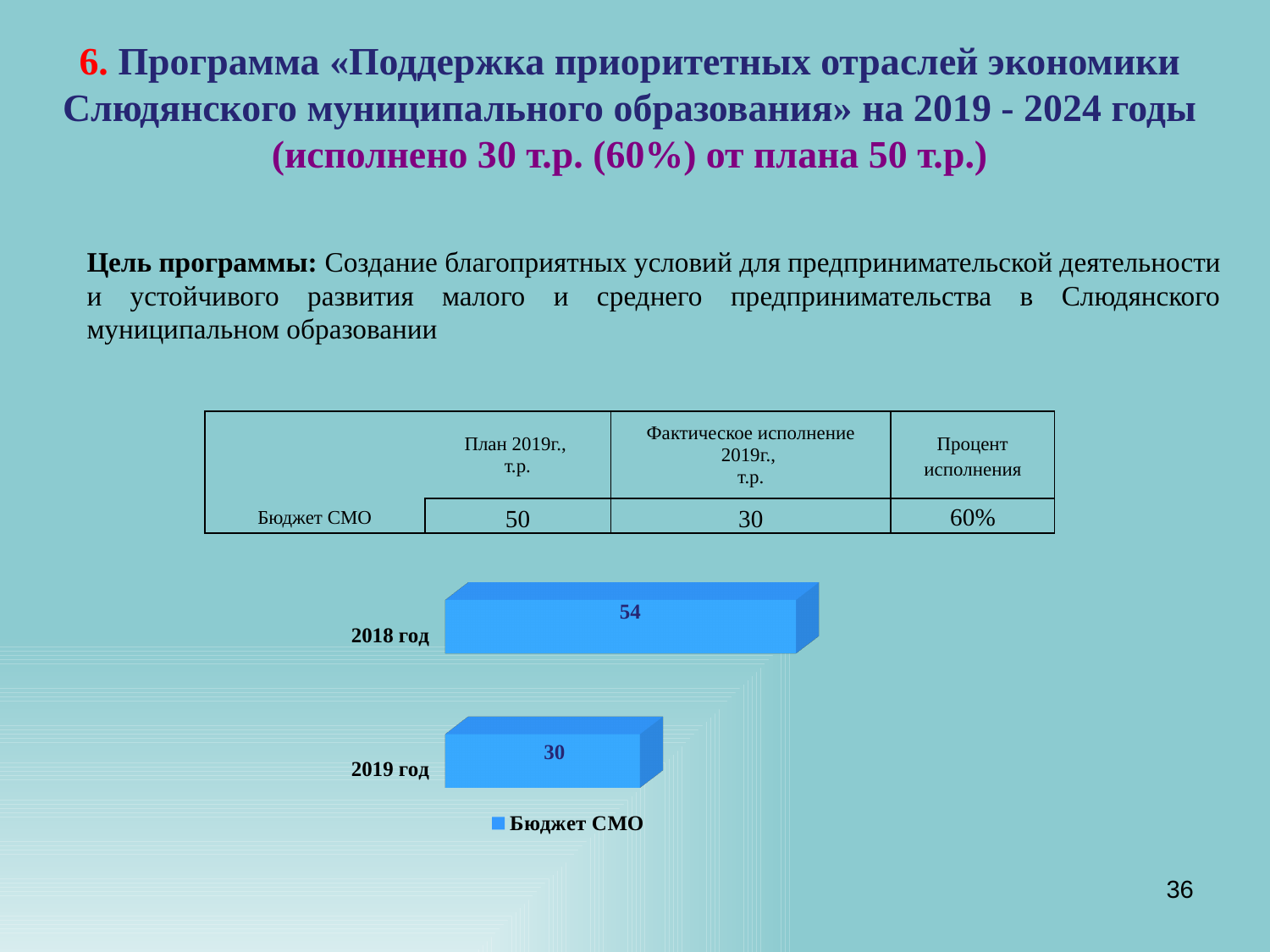
Is the value for 2019 год larger or smaller than the value for 2018 год? smaller What is the value for 2018 год in the chart? 54 What kind of chart is shown on the slide? bar chart What is the name of the series shown in the chart legend? Бюджет СМО What colour are the bars in the chart? blue What is the difference between the values for 2018 год and 2019 год? 24 How many series does the chart legend list? 1 What is the value for 2019 год in the chart? 30 Which year has the higher value in the chart? 2018 год Which year has the lower value in the chart? 2019 год How many categories (years) are shown in the chart? 2 Do the values rise or fall from 2018 год to 2019 год? fall